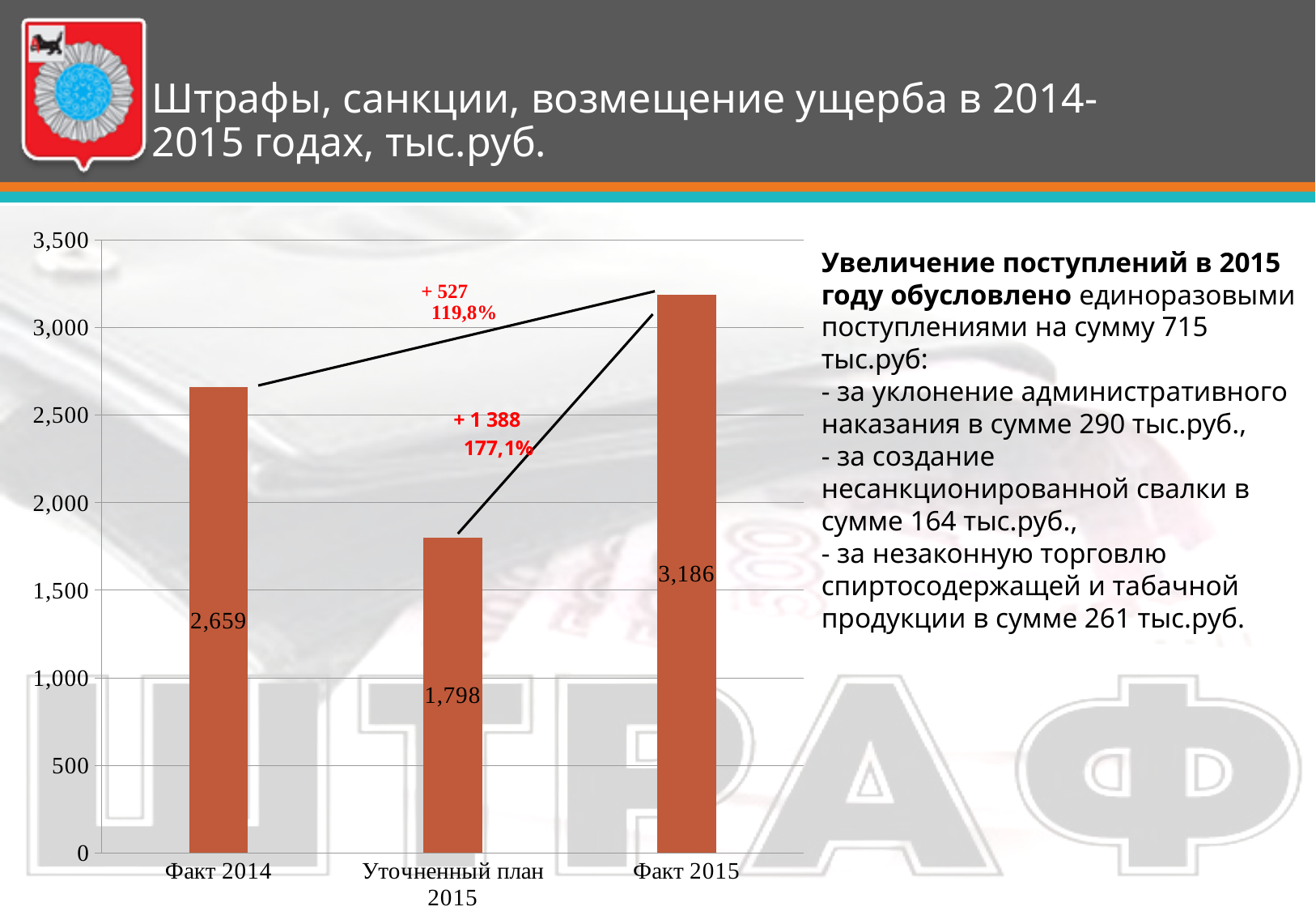
What is the difference between Факт 2015 and Факт 2014? 527 Which is larger, Факт 2014 or Уточненный план 2015? Факт 2014 Which category has the highest value? Факт 2015 What is the value for Факт 2014? 2,659 What is the value for Факт 2015? 3,186 What is the difference between Факт 2015 and Уточненный план 2015? 1,388 What kind of chart is shown on the slide? bar chart How many categories are shown on the chart? 3 Which category has the lowest value? Уточненный план 2015 What percentage is shown in the annotation between Уточненный план 2015 and Факт 2015? 177,1% What is the value for Уточненный план 2015? 1,798 Is the value for Факт 2015 greater or less than 3,000? greater